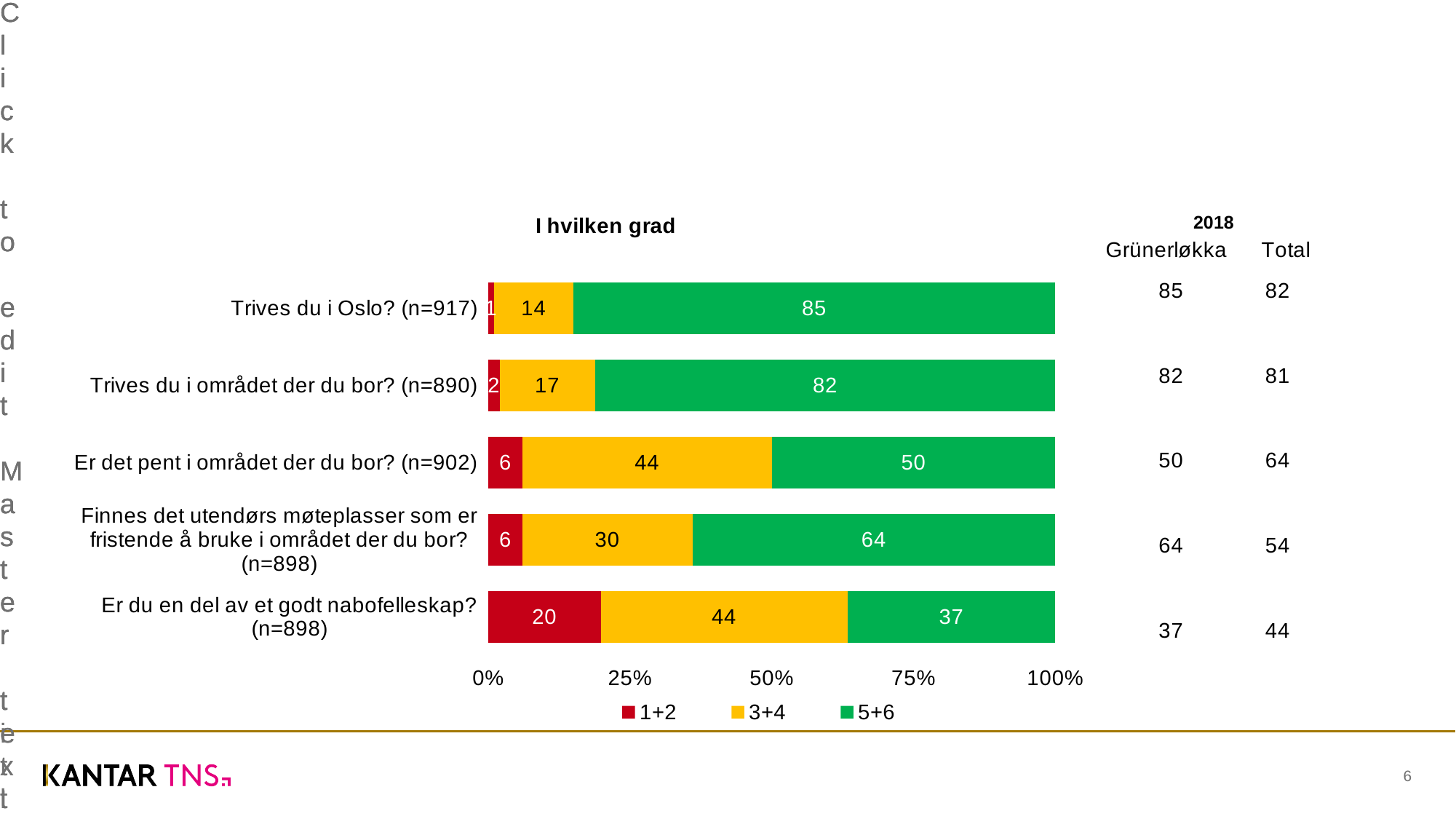
What is the value of the 5+6 series for "Trives du i Oslo? (n=917)"? 85 Which category has the lowest 5+6 value? Er du en del av et godt nabofelleskap? (n=898) What is the title of the chart? I hvilken grad What is the value of the 1+2 series for "Er du en del av et godt nabofelleskap? (n=898)"? 20 How many categories are shown in the chart? 5 What is the difference between the 5+6 values for "Trives du i Oslo? (n=917)" and "Trives du i området der du bor? (n=890)"? 3 What kind of chart is shown on the slide? Stacked bar chart What is the total of the stacked bar for "Er du en del av et godt nabofelleskap? (n=898)"? 101 Which category has the highest 5+6 value? Trives du i Oslo? (n=917) What is the value of the 3+4 series for "Er det pent i området der du bor? (n=902)"? 44 Which is larger: the 3+4 value for "Finnes det utendørs møteplasser som er fristende å bruke i området der du bor? (n=898)" or the 3+4 value for "Er det pent i området der du bor? (n=902)"? Er det pent i området der du bor? (n=902) How many series does the legend list? 3